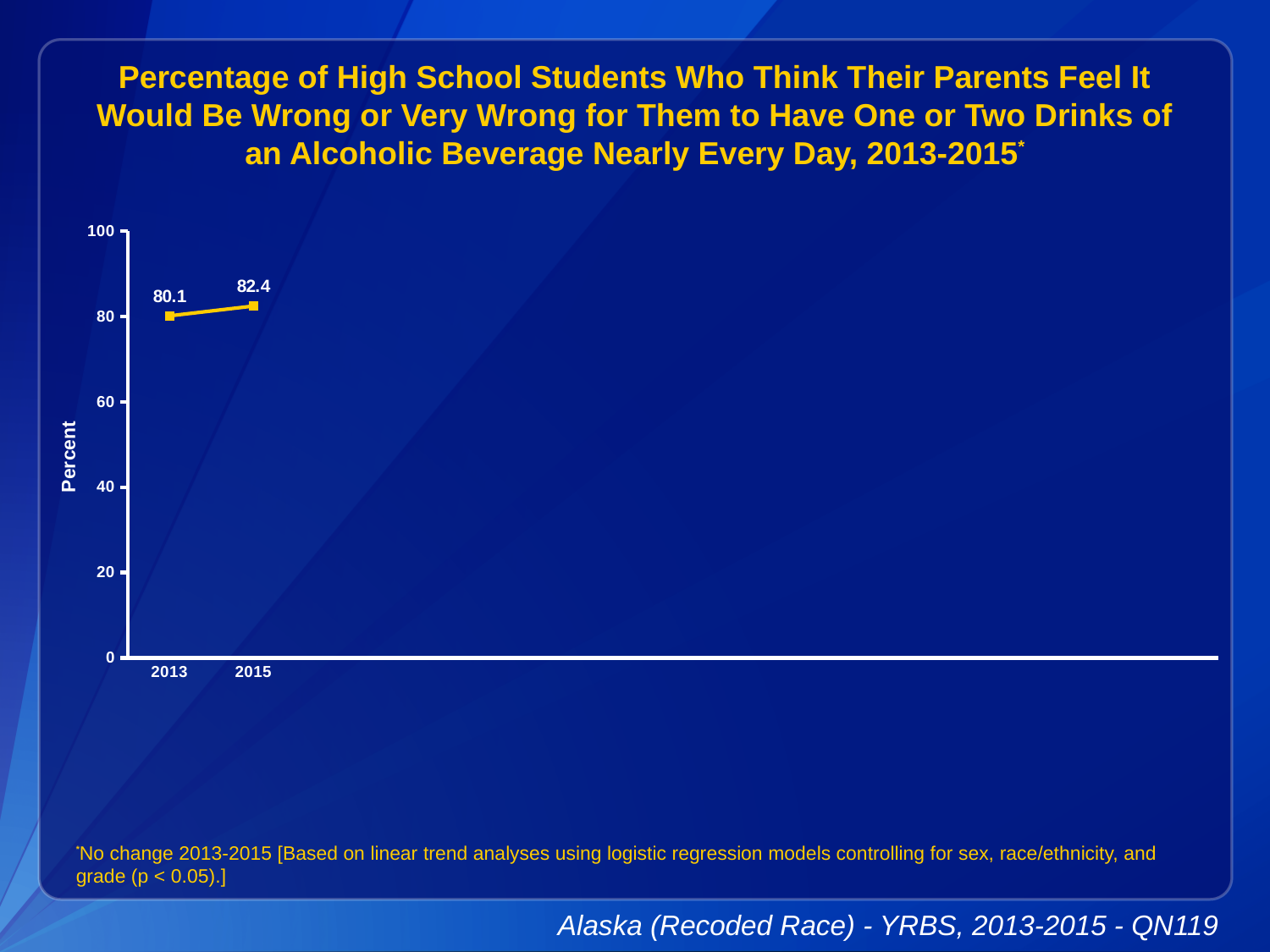
What is the label on the vertical axis? Percent What is the value for 2015? 82.4 Is the value for 2013 greater or less than 60? greater What is the difference between the 2015 and 2013 values? 2.3 What kind of chart is shown on the slide? line chart Which year has the lower value? 2013 What is the value for 2013? 80.1 Do the values rise or fall from 2013 to 2015? rise What is the maximum value shown on the vertical axis? 100 How many data points are plotted on the chart? 2 Is the value for 2015 greater or less than 100? less Which year has the higher value? 2015